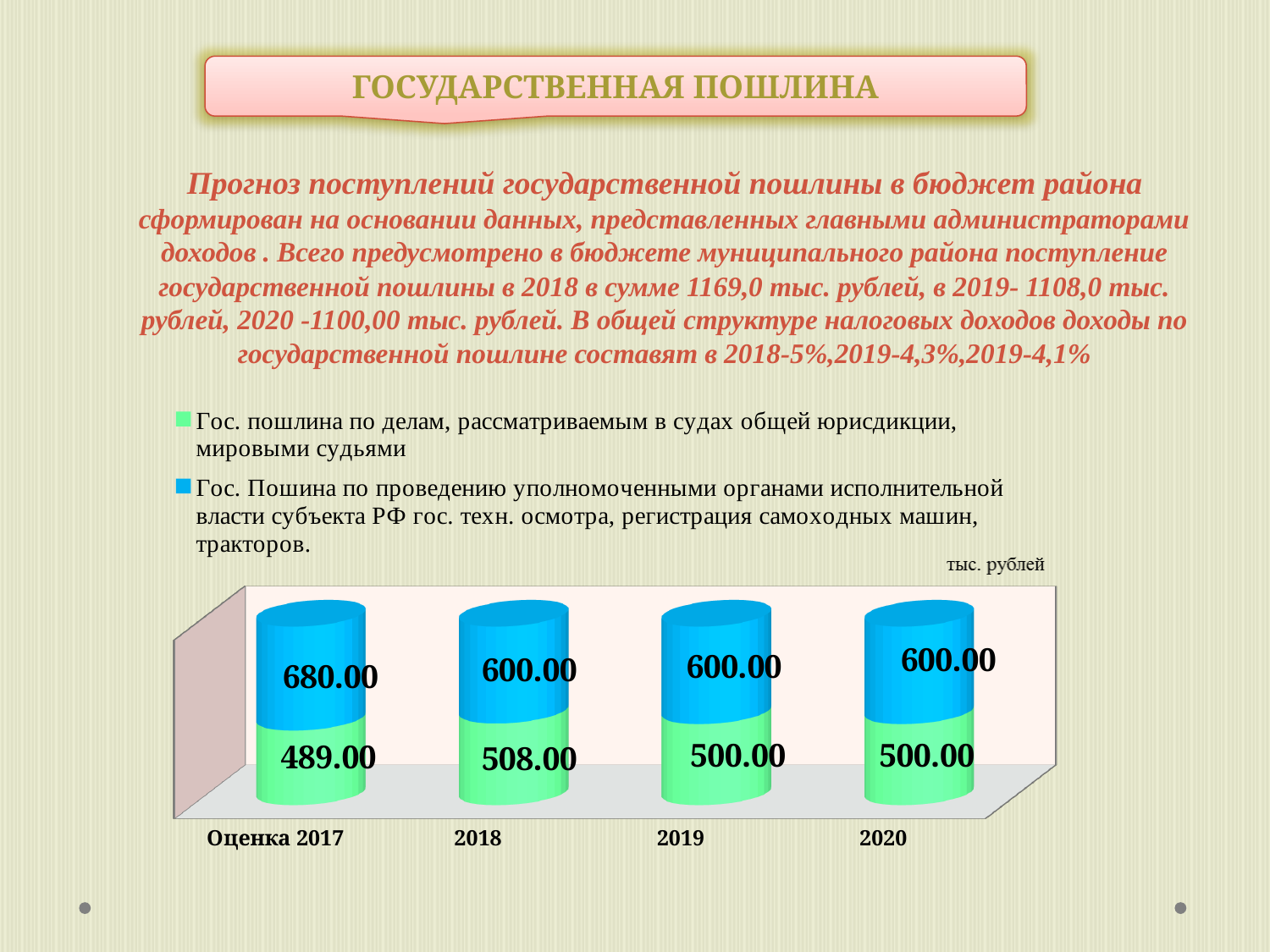
What unit is indicated above the chart? тыс. рублей In which category is the blue series (Гос. Пошина по проведению уполномоченными органами...) highest? Оценка 2017 How many series does the chart legend list? 2 What is the difference between the blue series value for Оценка 2017 and for 2018? 80.00 How many categories are shown on the x axis of the chart? 4 What kind of chart is shown on the slide? Stacked bar chart What is the value of the green series (Гос. пошлина по делам, рассматриваемым в судах общей юрисдикции, мировыми судьями) for 2018? 508.00 Which is larger for 2019: the green series value or the blue series value? The blue series (600.00) What is the total of the stacked bar for Оценка 2017? 1169.00 What is the value of the green series (Гос. пошлина по делам, рассматриваемым в судах общей юрисдикции, мировыми судьями) for 2020? 500.00 What is the value of the blue series (Гос. Пошина по проведению уполномоченными органами исполнительной власти субъекта РФ гос. техн. осмотра, регистрация самоходных машин, тракторов) for Оценка 2017? 680.00 In which category is the green series (Гос. пошлина по делам, рассматриваемым в судах общей юрисдикции, мировыми судьями) lowest? Оценка 2017